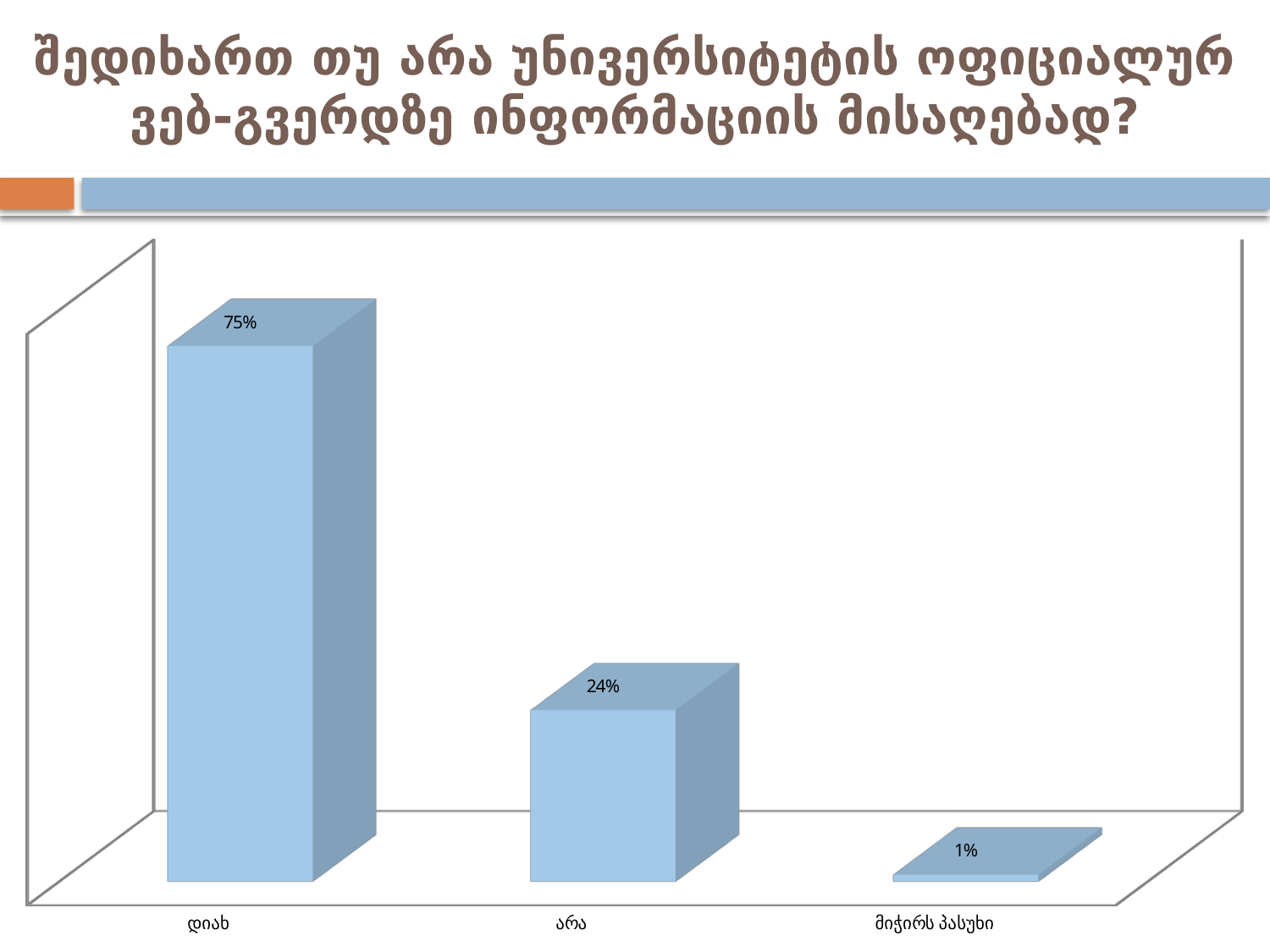
What is the value for მიჭირს პასუხი? 1% Do the values rise or fall from left to right across the categories? fall What is the difference between the values for არა and მიჭირს პასუხი? 23% What is the title of the slide? შედიხართ თუ არა უნივერსიტეტის ოფიციალურ ვებ-გვერდზე ინფორმაციის მისაღებად? Which category has the highest value? დიახ What kind of chart is shown on the slide? bar chart Which is larger, the value for არა or the value for მიჭირს პასუხი? არა What is the value for დიახ? 75% What is the difference between the values for დიახ and არა? 51% How many categories are shown in the chart? 3 What is the value for არა? 24% Which category has the lowest value? მიჭირს პასუხი